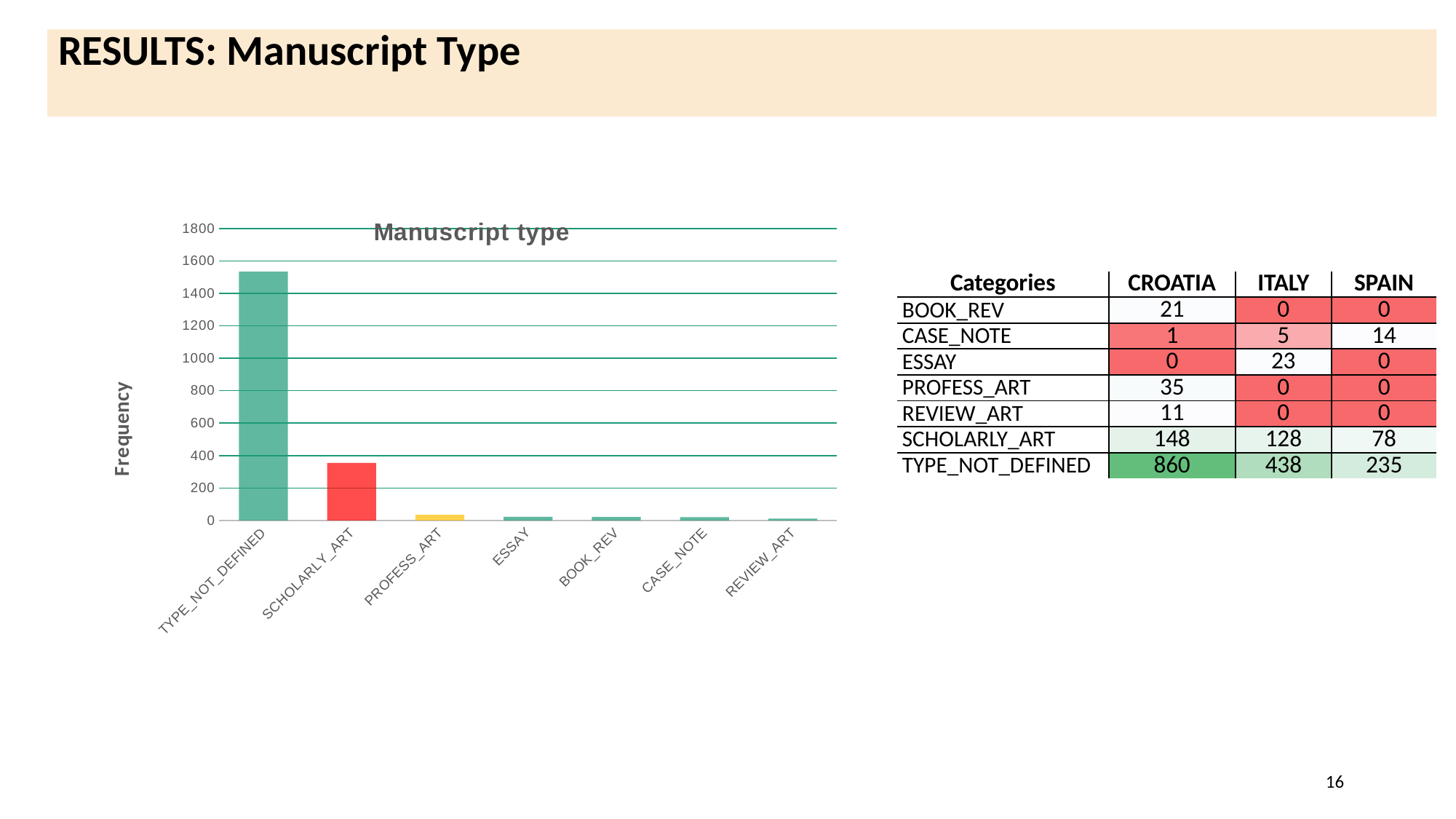
Which category has the lowest frequency in the chart? REVIEW_ART Is the frequency for SCHOLARLY_ART greater or less than 400? less Is the frequency for TYPE_NOT_DEFINED greater or less than 1400? greater How many categories are shown on the x axis of the chart? 7 What kind of chart is shown on the slide? bar chart Is the frequency for SCHOLARLY_ART greater or less than 200? greater What is the label on the vertical axis of the chart? Frequency What is the title of the chart? Manuscript type Which category has the highest frequency in the chart? TYPE_NOT_DEFINED Which has a higher frequency, SCHOLARLY_ART or PROFESS_ART? SCHOLARLY_ART